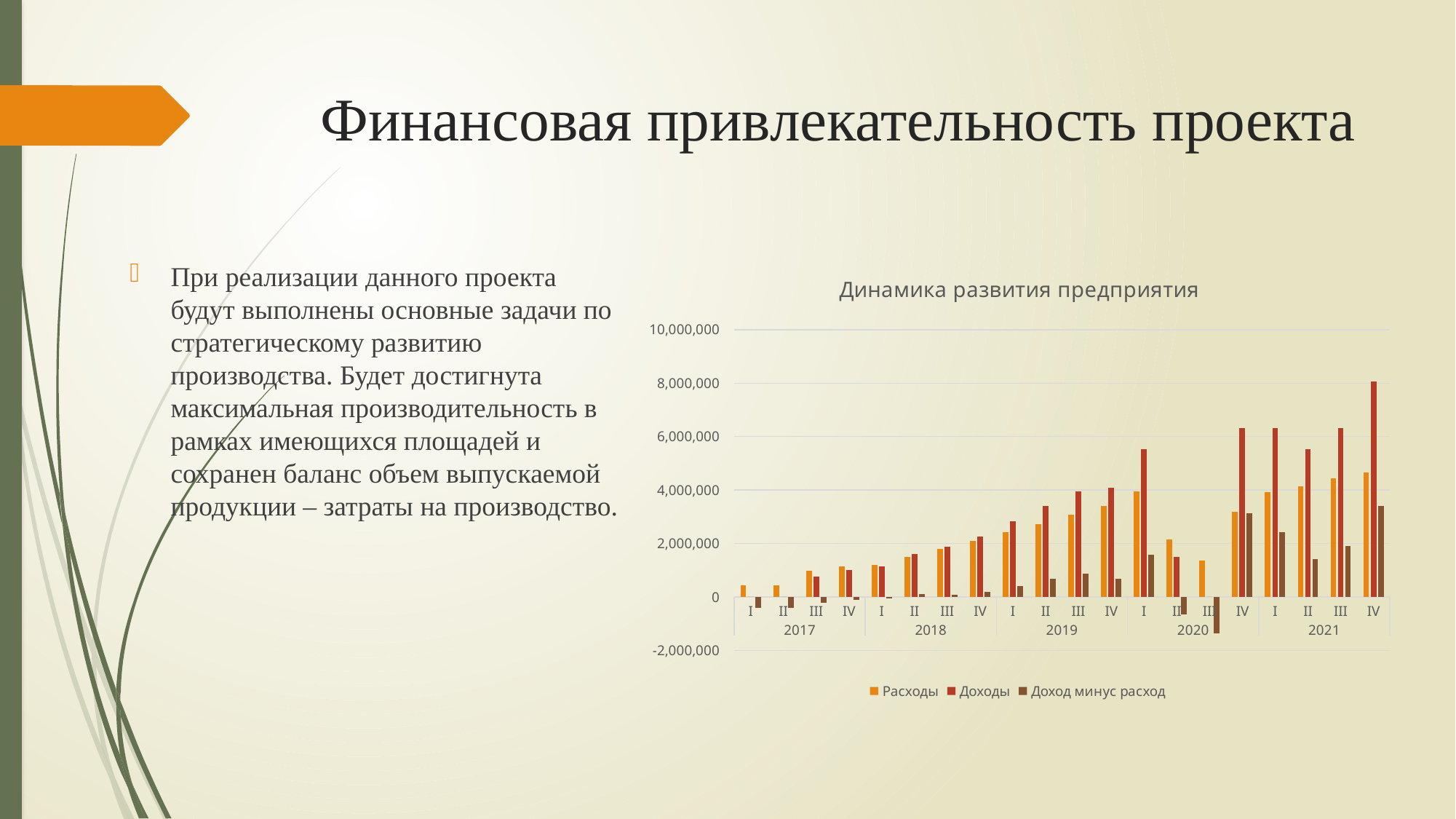
Is the value of Доход минус расход for III 2020 greater or less than 0? less In IV 2021, which is larger: Расходы or Доходы? Доходы Is the value of Доходы for IV 2021 greater or less than 6,000,000? greater How many series does the chart legend list? 3 What kind of chart is shown on the slide? bar chart What is the title of the chart? Динамика развития предприятия How many quarterly categories are plotted along the x axis? 20 In which quarter is the value of Доход минус расход lowest? III 2020 In which quarter is the value of Доходы highest? IV 2021 Do the values of Доходы generally rise or fall from 2017 to 2021? rise Is the value of Расходы for I 2017 greater or less than 2,000,000? less How many years are shown along the x axis of the chart? 5